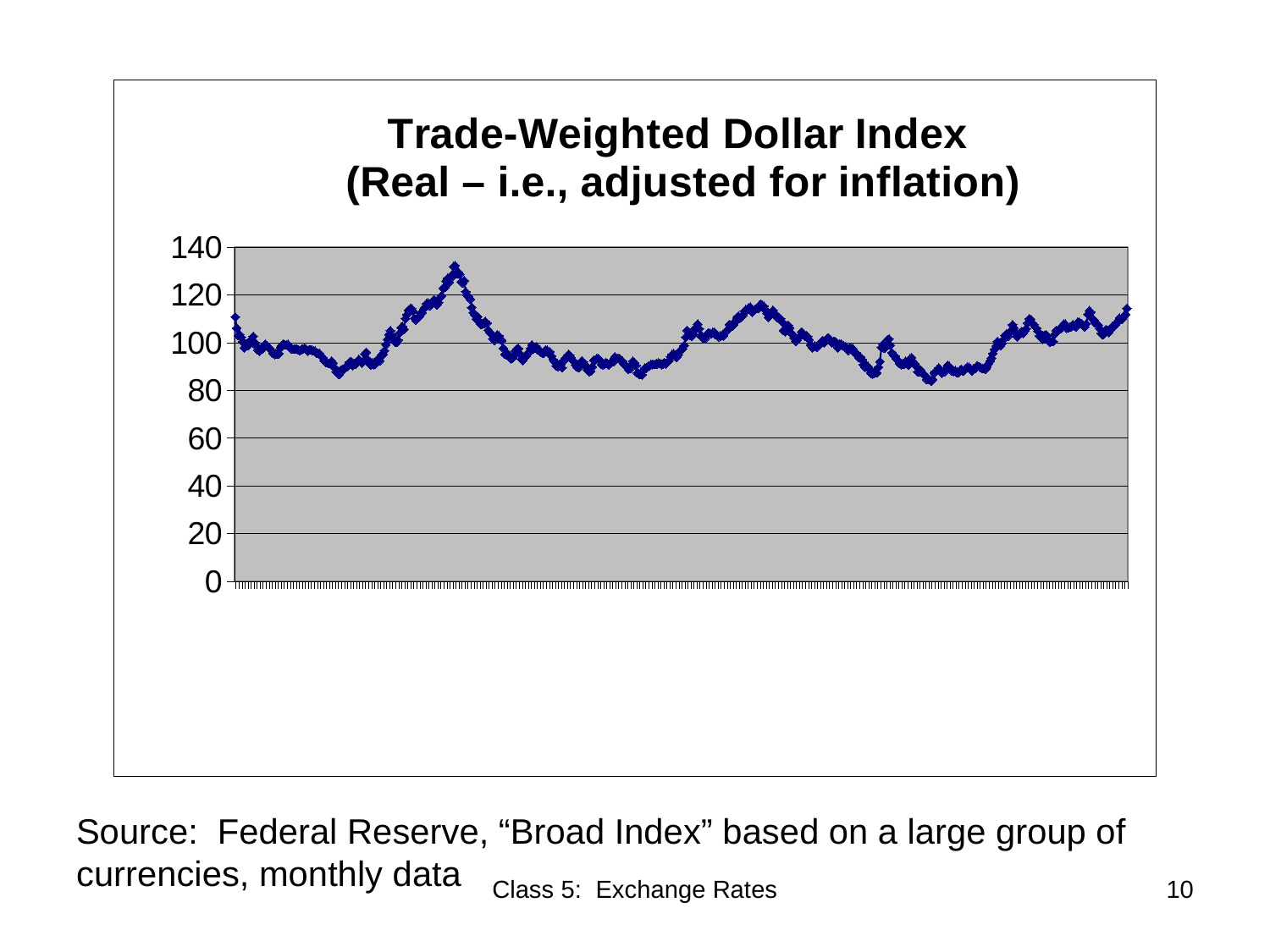
Is the value at the far right end of the Trade-Weighted Dollar Index line greater or less than 100? greater Is the peak value of the Trade-Weighted Dollar Index line greater or less than 140? less Is the lowest value of the Trade-Weighted Dollar Index line greater or less than 100? less What kind of chart is shown on the slide? line chart What is the highest value shown on the vertical axis of the chart? 140 What is the title of the chart? Trade-Weighted Dollar Index (Real – i.e., adjusted for inflation)